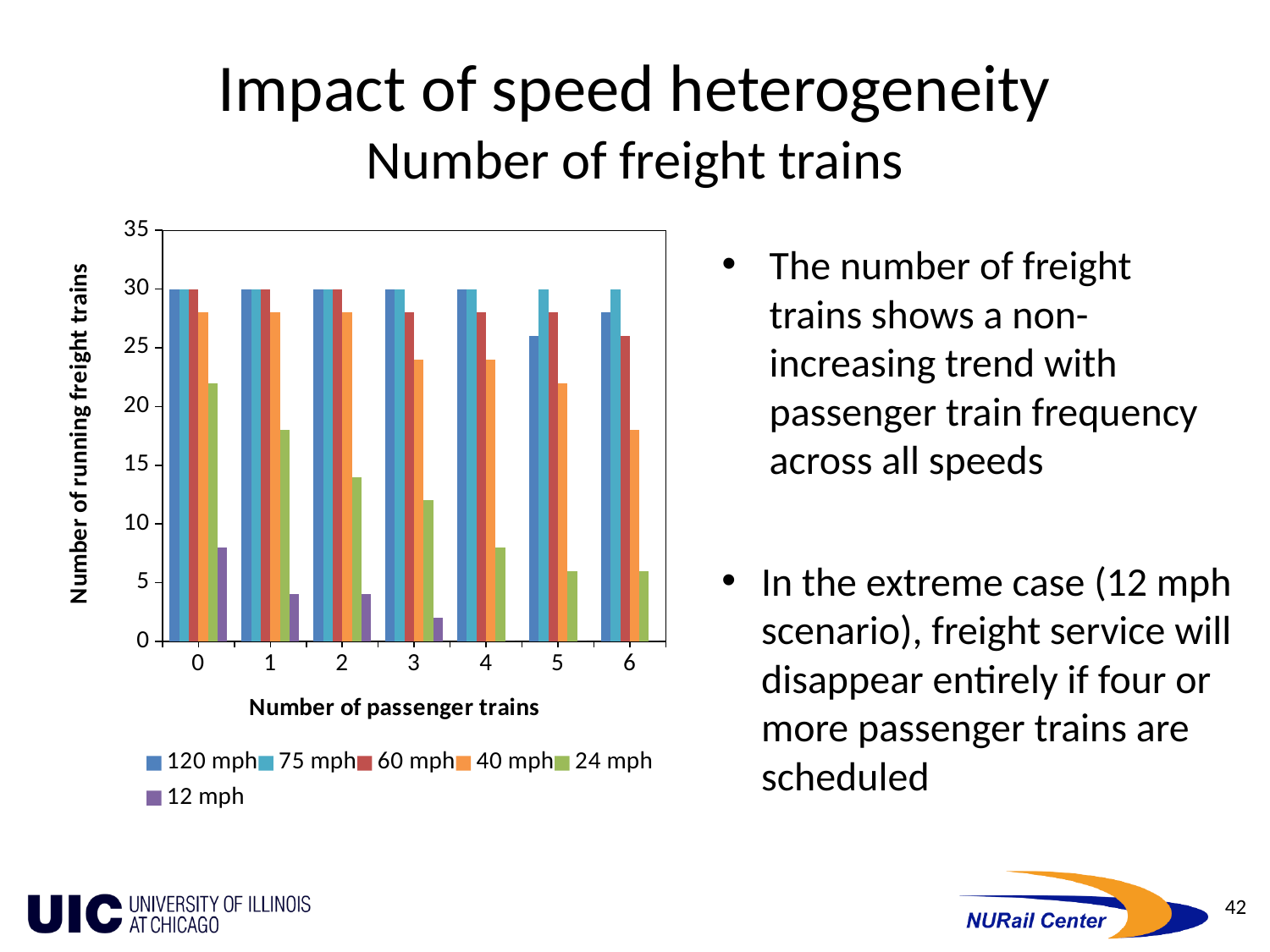
At 0 passenger trains, which speed series has the lowest number of running freight trains? 12 mph Is the value for the 40 mph series at 6 passenger trains greater or less than 20? less Is the value for the 24 mph series at 0 passenger trains greater or less than 20? greater What is the number of running freight trains for the 75 mph series at 6 passenger trains? 30 How many series does the legend list? 6 At 3 passenger trains, which is larger: the 40 mph series or the 24 mph series? 40 mph What is the label of the y axis? Number of running freight trains What is the number of running freight trains for the 120 mph series at 0 passenger trains? 30 How does the number of running freight trains for the 24 mph series change as the number of passenger trains increases? It falls What type of chart is shown on the slide? bar chart Is the value for the 12 mph series at 1 passenger train greater or less than 5? less How many passenger-train categories are shown on the x axis? 7